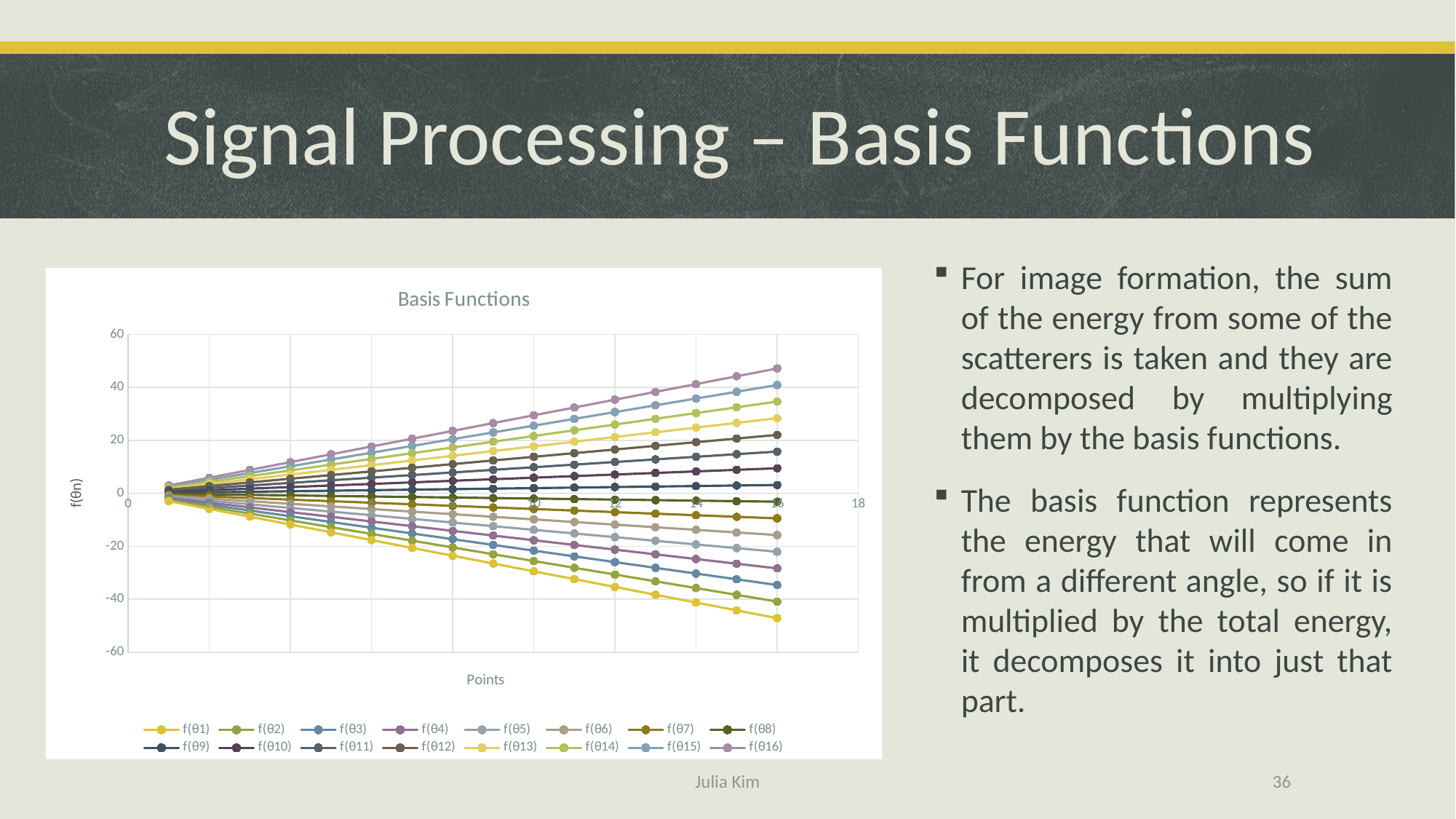
Is the value of f(θ16) at x = 16 greater or less than 40? greater What is the title of the chart? Basis Functions How many data points does each series have along the x axis? 16 How many series does the legend of the chart list? 16 Which series reaches the lowest value at x = 16? f(θ1) Is the value of f(θ1) at x = 16 greater or less than -40? less Does the f(θ1) series rise or fall as the x axis increases? falls Does the f(θ16) series rise or fall as the x axis increases? rises Which series reaches the highest value at x = 16? f(θ16) What kind of chart is shown on the slide? line chart What is the label of the x axis of the chart? Points At x = 16, which is larger: the value of f(θ16) or the value of f(θ15)? f(θ16)